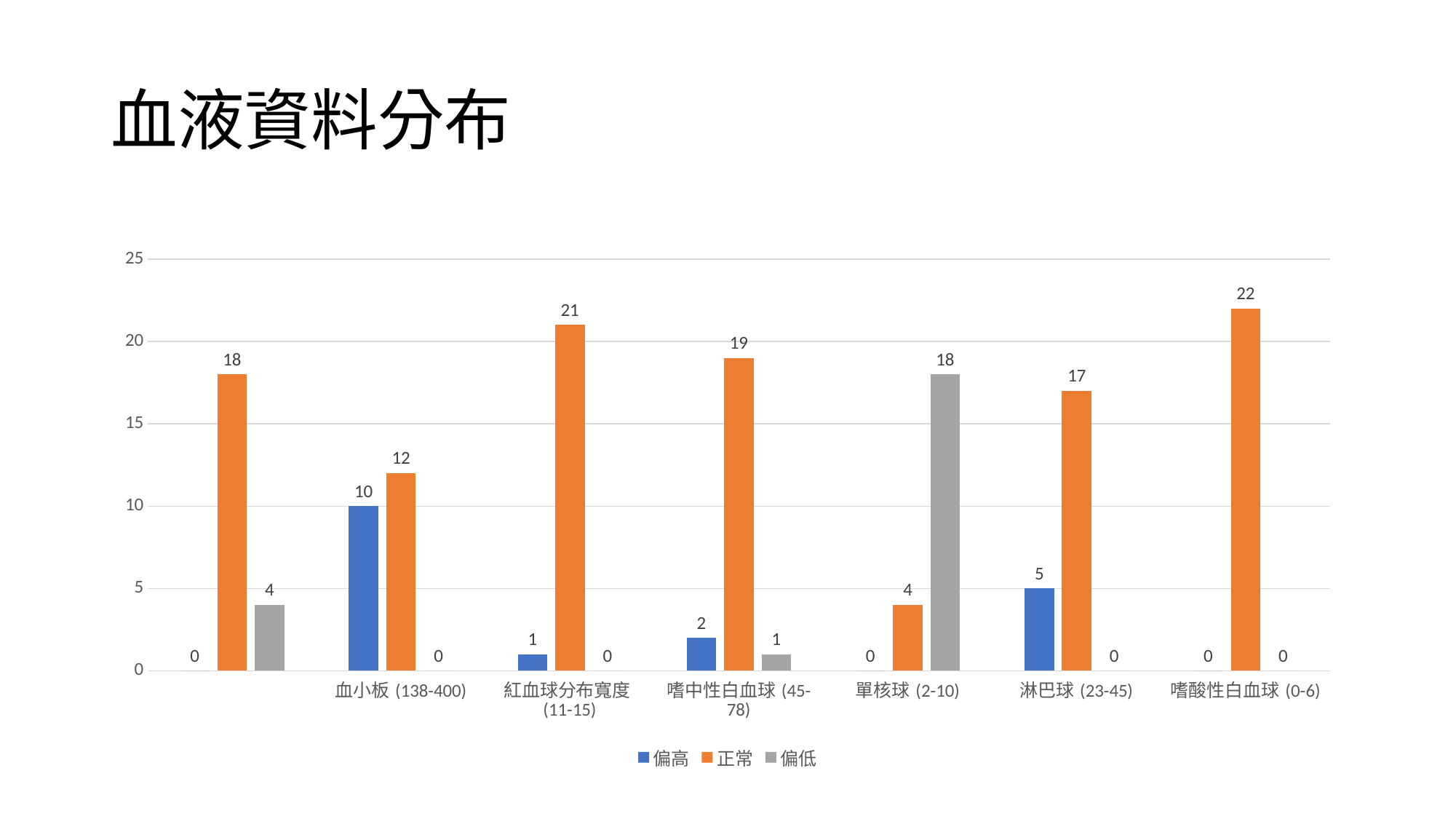
What is the difference between the 正常 values for 紅血球分布寬度 (11-15) and 嗜中性白血球 (45-78)? 2 Which labeled category has the highest 偏高 value? 血小板 (138-400) How many series does the legend list? 3 What is the total of the three series values for 淋巴球 (23-45)? 22 What is the 正常 value for 淋巴球 (23-45)? 17 Which is larger for 單核球 (2-10): the 正常 value or the 偏低 value? 偏低 What type of chart is shown on the slide? bar chart What is the 偏高 value for 血小板 (138-400)? 10 Which category has the highest 正常 value? 嗜酸性白血球 (0-6) What is the 正常 value for 嗜酸性白血球 (0-6)? 22 What is the title of the slide? 血液資料分布 What is the 偏低 value for 單核球 (2-10)? 18